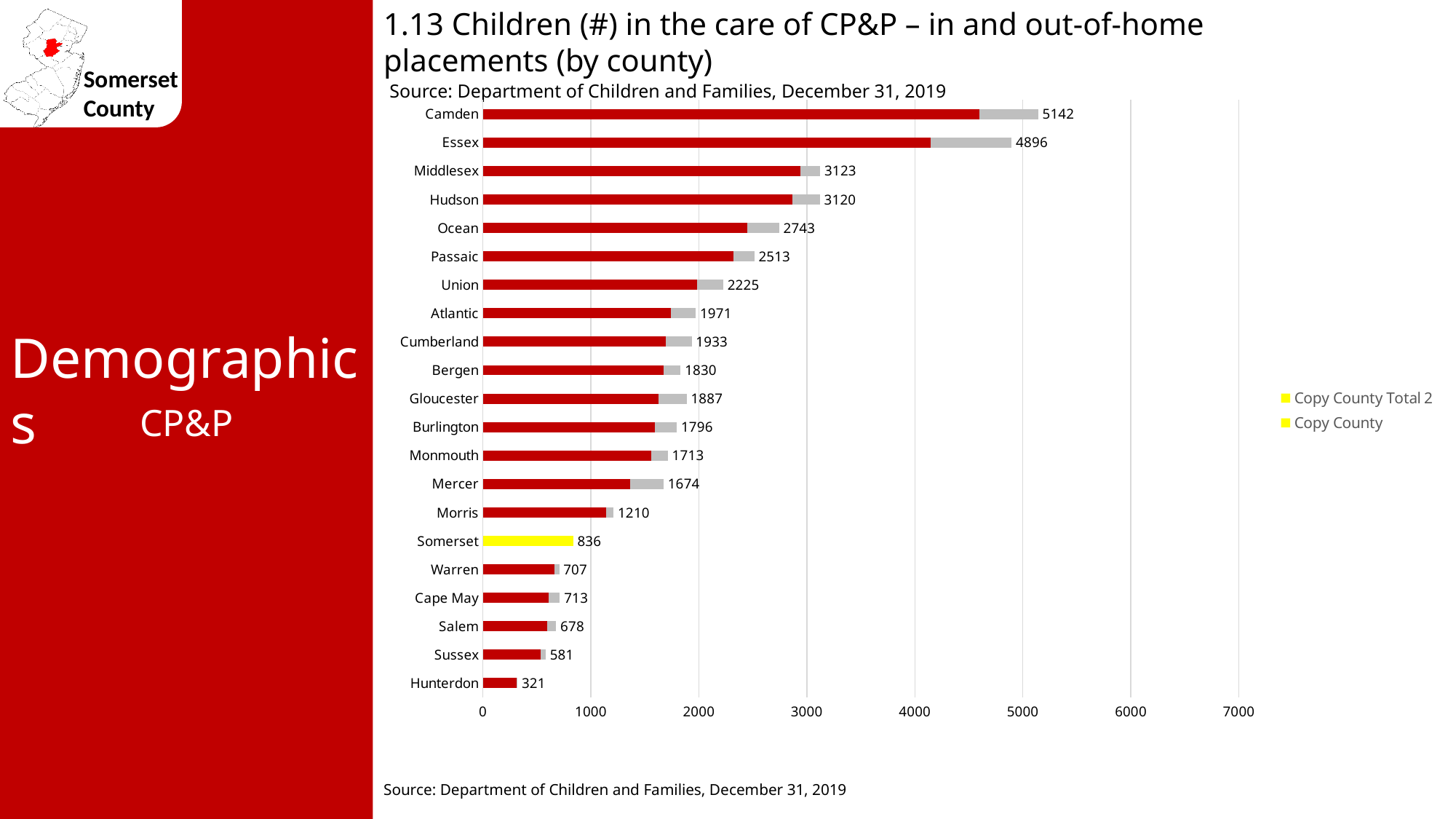
What value is labelled for Hunterdon? 321 Is the labelled value for Ocean greater or less than 3000? less What value is labelled for Somerset on the chart? 836 How many counties are listed on the chart? 21 How many entries does the legend list? 2 Which county has the lowest labelled value on the chart? Hunterdon What is the total number of children in the care of CP&P shown for Camden? 5142 What is the difference between the labelled values for Camden and Essex? 246 What is the difference between the labelled values for Somerset and Morris? 374 Which county has the highest labelled value on the chart? Camden Which has a larger labelled value, Gloucester or Bergen? Gloucester What kind of chart is shown on the slide? Bar chart